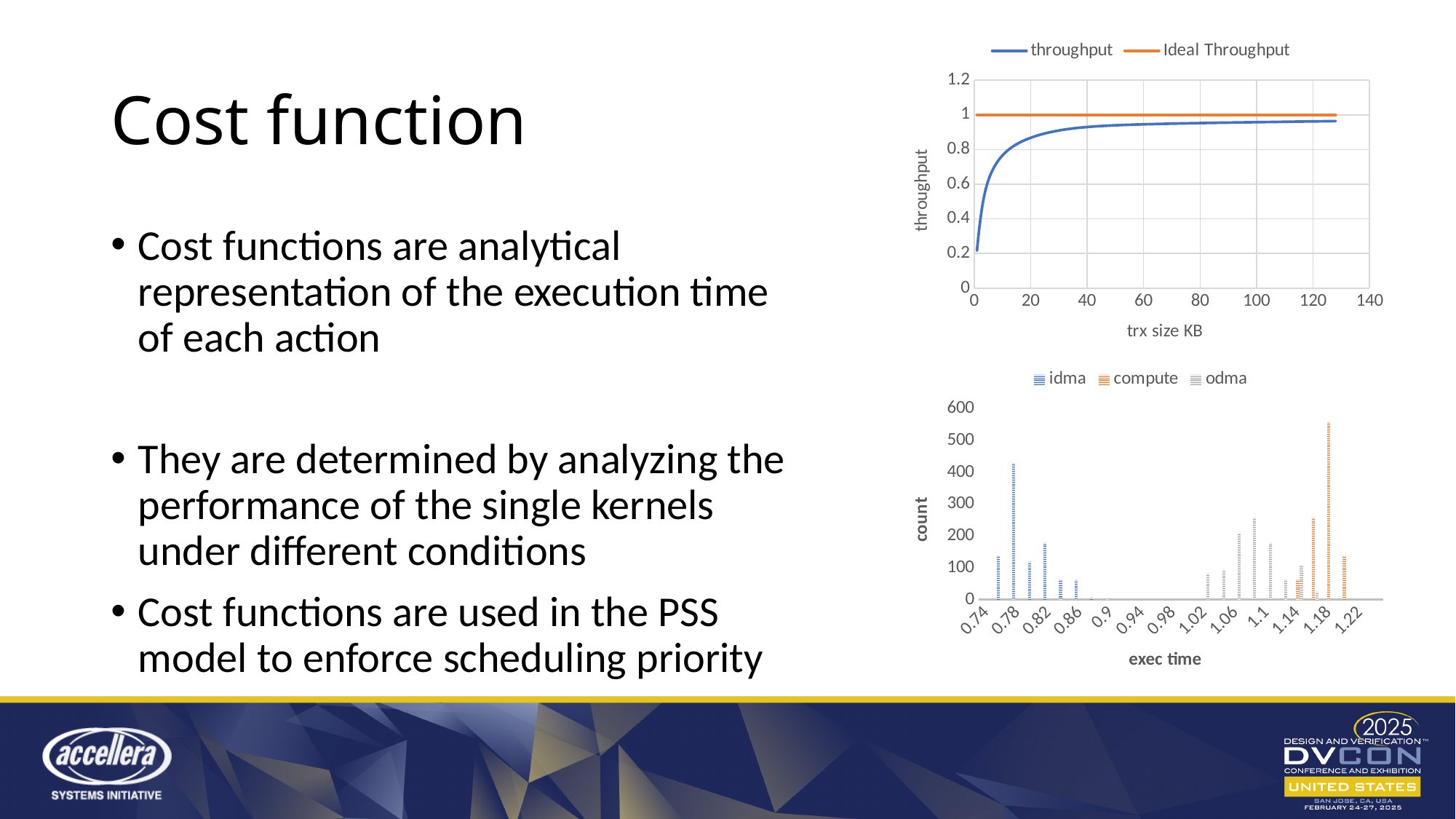
On the bottom chart, is the tallest compute bar greater or less than 500? greater On the top chart, what is the label of the x axis? trx size KB On the bottom chart, is the tallest odma bar greater or less than 300? less On the top chart, which series is higher at trx size 40 KB, throughput or Ideal Throughput? Ideal Throughput On the top chart, how many series does the legend list? 2 On the top chart, is the throughput value at trx size 20 KB greater or less than 0.6? greater On the bottom chart, what kind of chart is shown? bar chart On the top chart, does the throughput series rise or fall as trx size KB increases? rise On the top chart, what kind of chart is shown? line chart On the bottom chart, how many series does the legend list? 3 On the bottom chart, which series has the tallest bar? compute